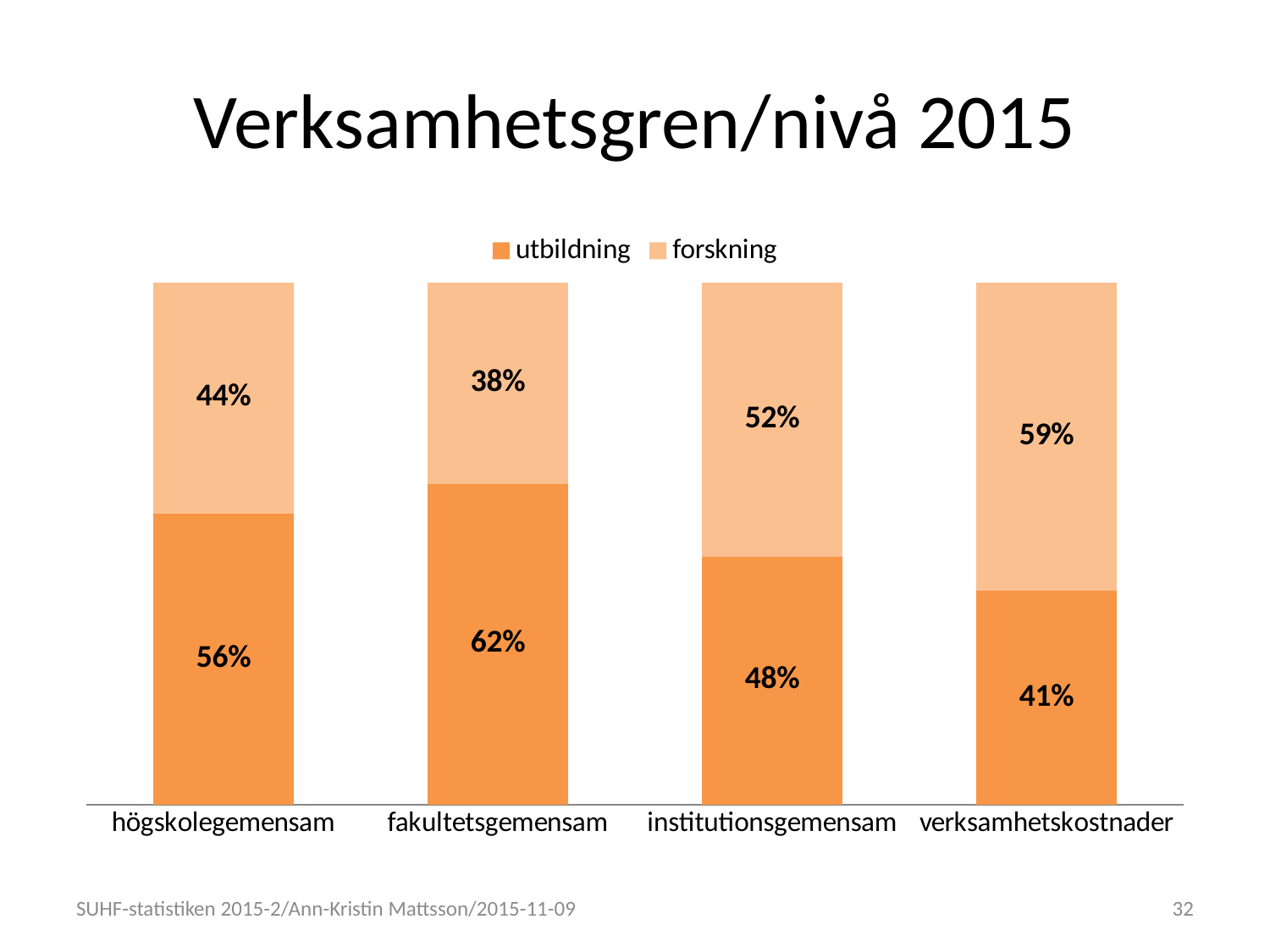
What is the utbildning value for högskolegemensam? 56% How many series does the legend list? 2 Which is larger for institutionsgemensam, utbildning or forskning? forskning Which category has the lowest forskning share? fakultetsgemensam What is the difference between the utbildning and forskning values for verksamhetskostnader? 18% What is the forskning value for fakultetsgemensam? 38% How many categories are shown on the x axis? 4 What is the title of the chart? Verksamhetsgren/nivå 2015 What kind of chart is shown on the slide? stacked bar chart Which category has the highest utbildning share? fakultetsgemensam What is the forskning value for institutionsgemensam? 52% What is the utbildning value for verksamhetskostnader? 41%